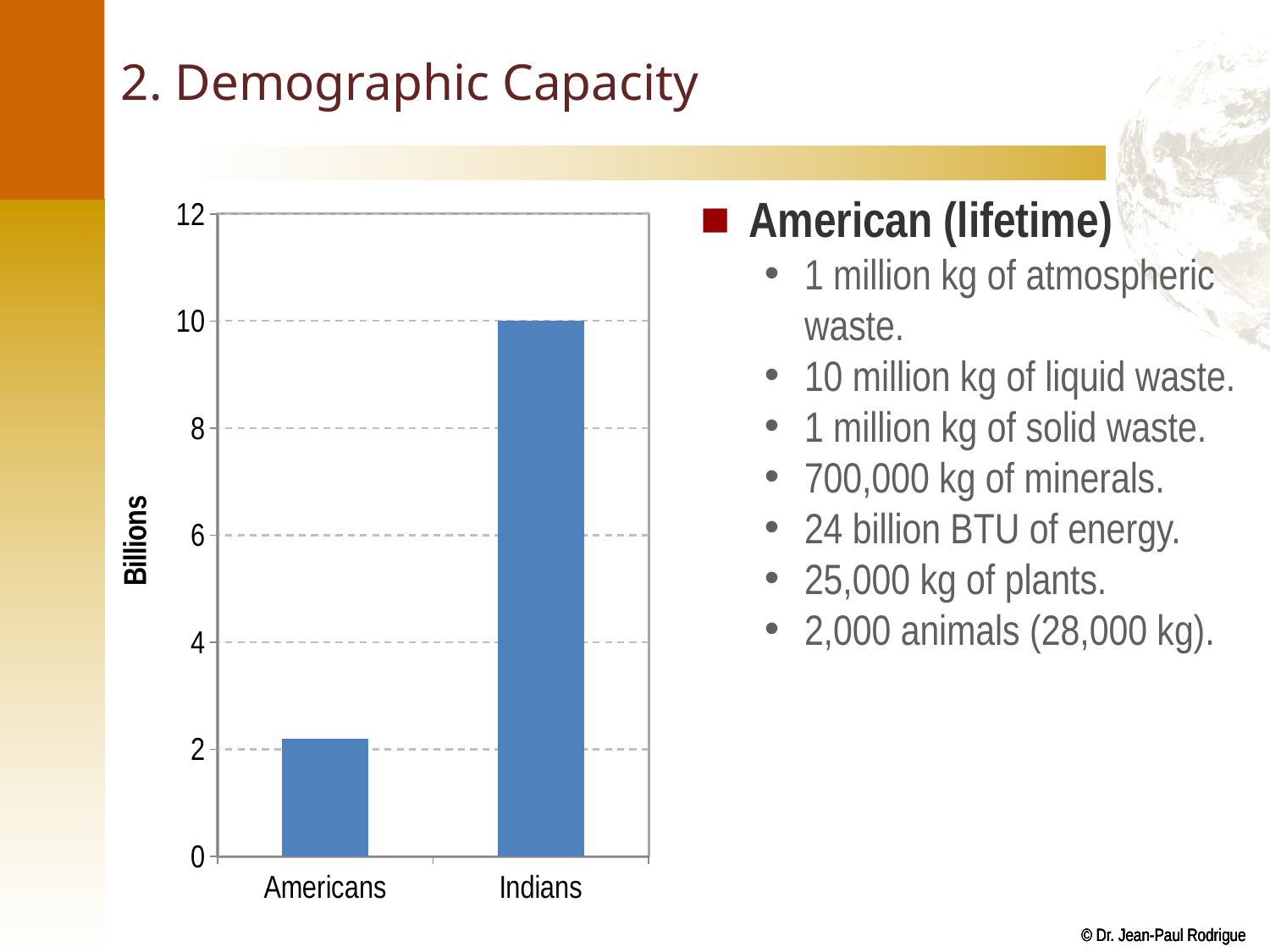
Which is larger, the value for Americans or the value for Indians? Indians Is the value for Indians greater or less than 8? greater What is the label on the vertical axis of the chart? Billions How many categories are plotted on the x axis of the chart? 2 Which category has the highest bar in the chart? Indians Is the value for Americans greater or less than 4? less What is the value for Indians in the chart? 10 What type of chart is shown on the slide? bar chart Which category has the lowest bar in the chart? Americans What is the maximum value shown on the vertical axis of the chart? 12